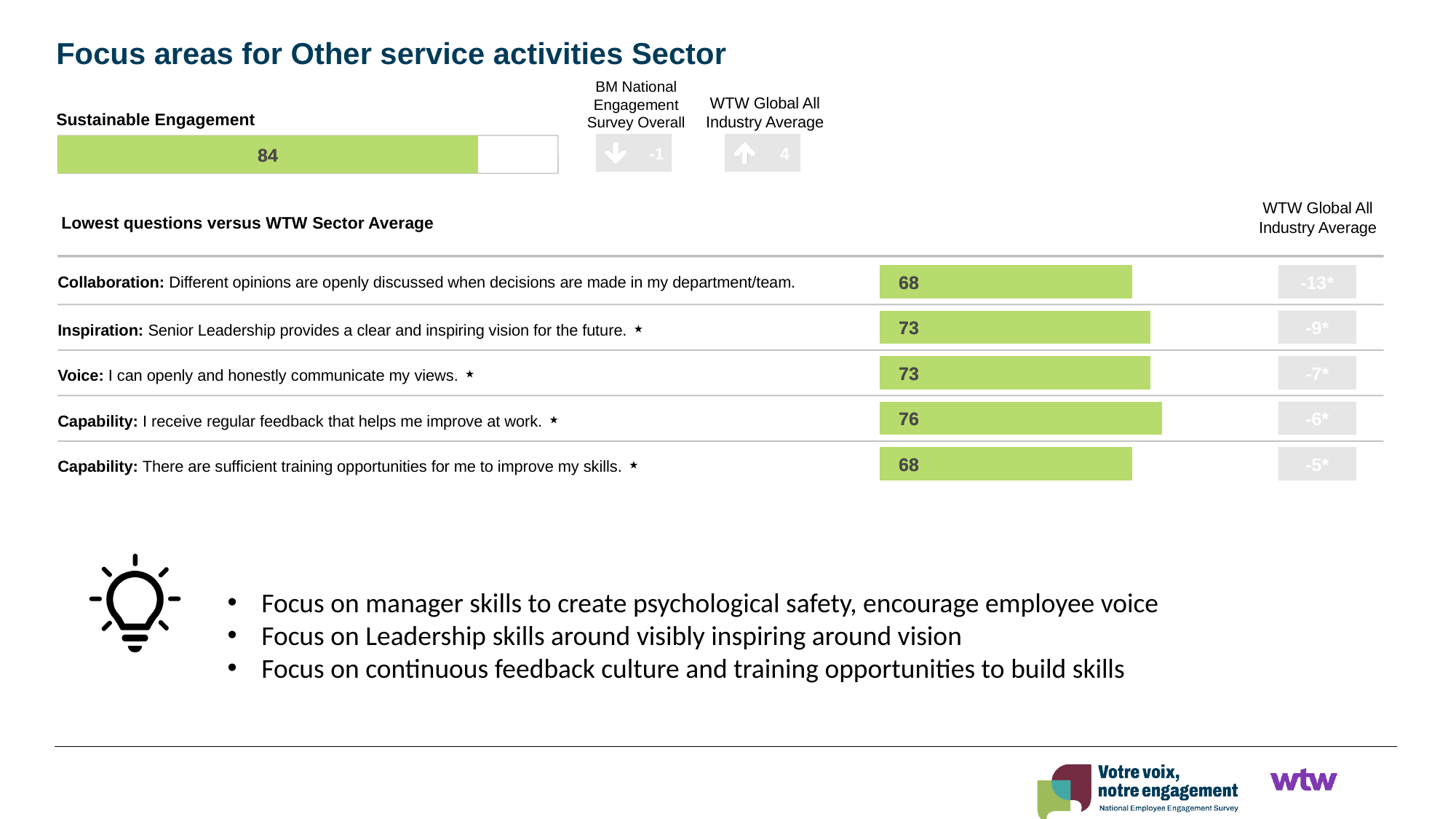
What is the difference versus the WTW Global All Industry Average shown next to the Sustainable Engagement score? 4 In the 'Lowest questions versus WTW Sector Average' chart, which is larger: the value for the Voice question or the value for the Capability training opportunities question? Voice What is the difference versus the BM National Engagement Survey Overall shown next to the Sustainable Engagement score? -1 In the 'Lowest questions versus WTW Sector Average' chart, what is the difference between the Capability feedback question (76) and the Collaboration question (68)? 8 In the 'Lowest questions versus WTW Sector Average' chart, what is the value for the Inspiration question about Senior Leadership providing a clear and inspiring vision? 73 What is the Sustainable Engagement score shown on the slide? 84 In the 'Lowest questions versus WTW Sector Average' chart, what is the value for the Collaboration question about different opinions being openly discussed? 68 How many questions are listed in the 'Lowest questions versus WTW Sector Average' chart? 5 In the 'Lowest questions versus WTW Sector Average' chart, what is the value for the Capability question about receiving regular feedback? 76 What is the WTW Global All Industry Average difference shown next to the Collaboration question? -13* In the 'Lowest questions versus WTW Sector Average' chart, which question has the highest value? Capability: I receive regular feedback that helps me improve at work. What kind of chart is used to show the values in the 'Lowest questions versus WTW Sector Average' section? Bar chart